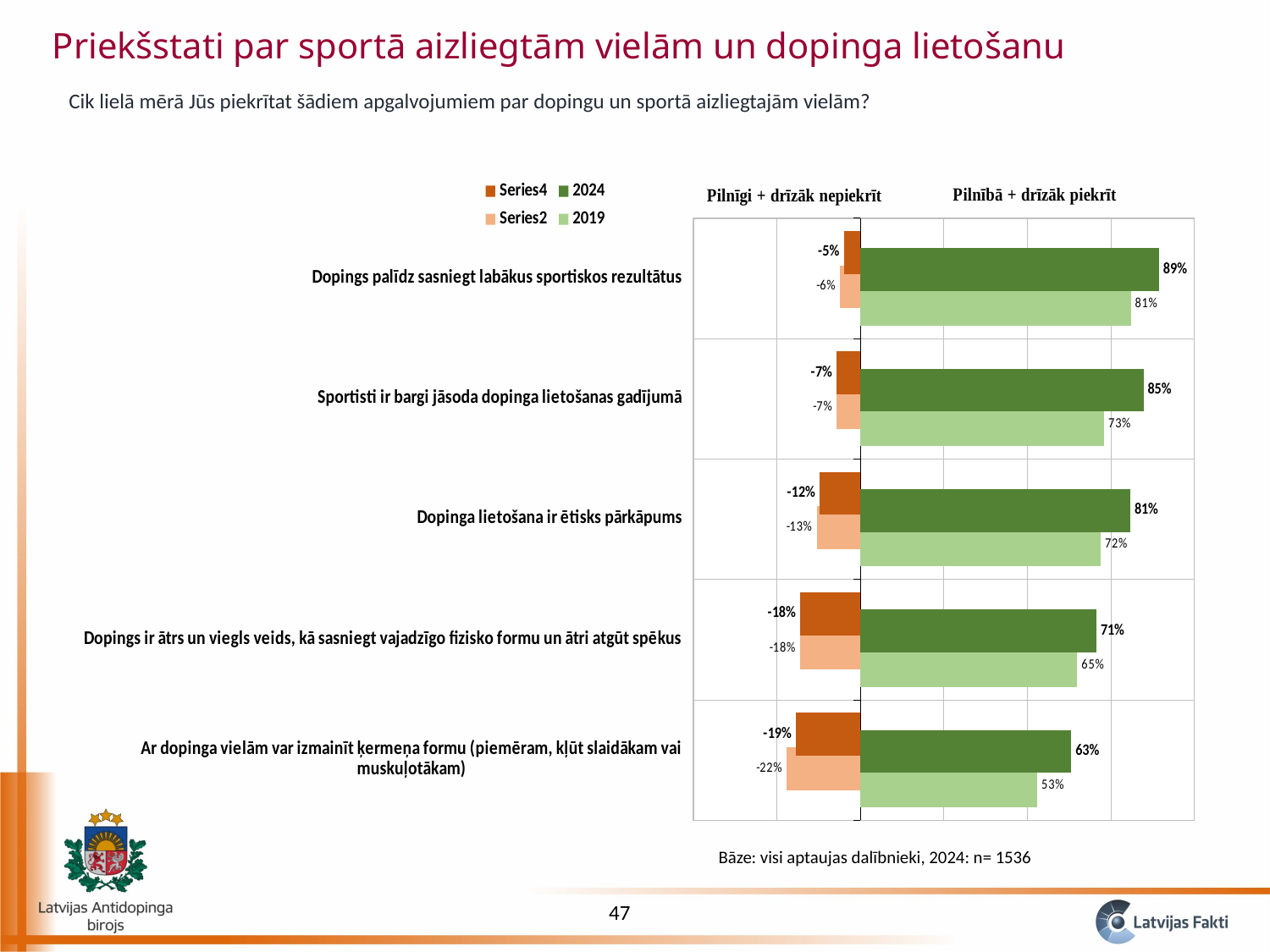
Which statement has the lowest 2019 value? Ar dopinga vielām var izmainīt ķermeņa formu (piemēram, kļūt slaidākam vai muskuļotākam) How many series does the legend list? 4 Which is larger for "Dopings ir ātrs un viegls veids, kā sasniegt vajadzīgo fizisko formu un ātri atgūt spēkus": the 2024 value or the 2019 value? 2024 What is the difference between the 2024 and 2019 values for "Dopinga lietošana ir ētisks pārkāpums"? 9 percentage points What is the 2024 value for "Dopings palīdz sasniegt labākus sportiskos rezultātus"? 89% What is the 2024 value for "Ar dopinga vielām var izmainīt ķermeņa formu (piemēram, kļūt slaidākam vai muskuļotākam)"? 63% Which statement has the highest 2024 value? Dopings palīdz sasniegt labākus sportiskos rezultātus What is the Series2 value for "Ar dopinga vielām var izmainīt ķermeņa formu (piemēram, kļūt slaidākam vai muskuļotākam)"? -22% What is the 2019 value for "Sportisti ir bargi jāsoda dopinga lietošanas gadījumā"? 73% What kind of chart is shown on the slide? Bar chart What is the Series4 value for "Dopinga lietošana ir ētisks pārkāpums"? -12% How many statements (categories) are shown in the chart? 5